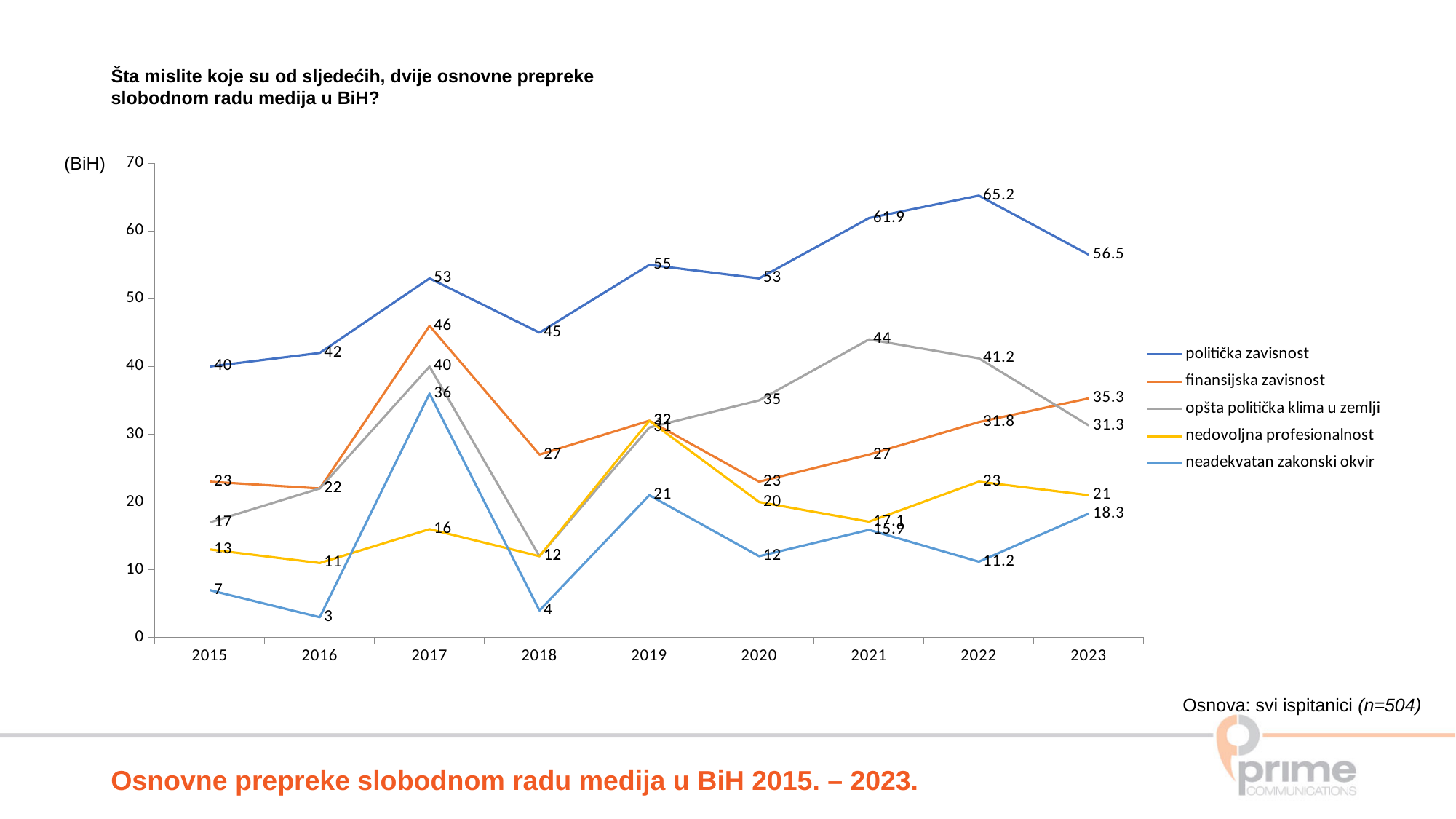
In which year does politička zavisnost reach its highest value? 2022 Does politička zavisnost generally rise or fall from 2015 to 2022? rise By how much did politička zavisnost fall from 2022 to 2023? 8.7 What is the value for finansijska zavisnost in 2017? 46 In which year is neadekvatan zakonski okvir at its lowest? 2016 What kind of chart is shown on the slide? line chart What is the value for opšta politička klima u zemlji in 2021? 44 What is the value for politička zavisnost in 2022? 65.2 How many series does the legend list? 5 How many years are shown on the x axis? 9 In 2023, which is larger: finansijska zavisnost or opšta politička klima u zemlji? finansijska zavisnost What is the difference between neadekvatan zakonski okvir in 2017 and in 2018? 32